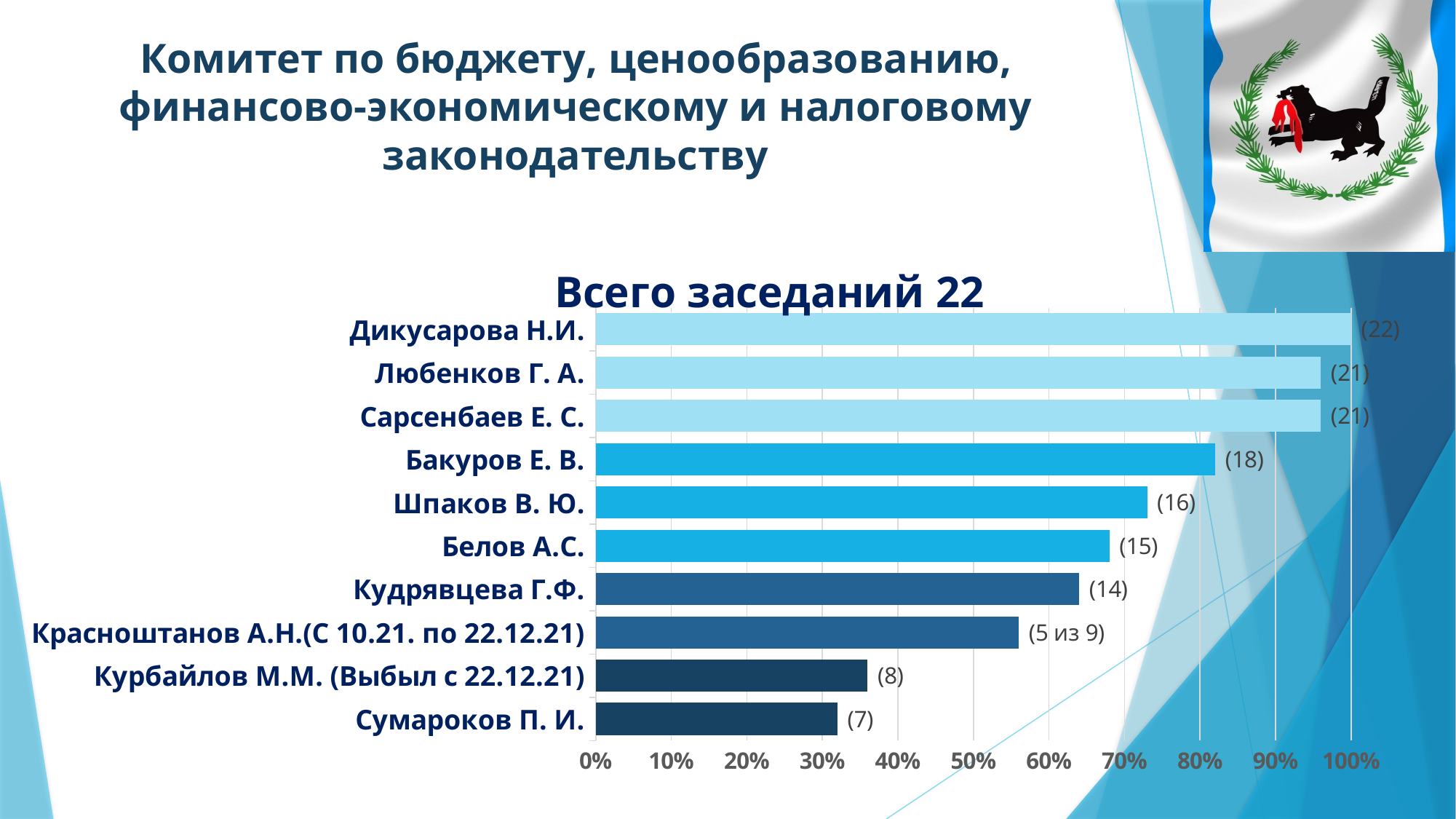
What is the data label shown for Бакуров Е. В.? (18) Which is larger, the value for Белов А.С. or the value for Кудрявцева Г.Ф.? Белов А.С. What is the title of the chart? Всего заседаний 22 How many categories (deputies) are shown in the chart? 10 What is the data label shown for Дикусарова Н.И.? (22) Which deputy has the lowest value in the chart? Сумароков П. И. Which deputy has the highest value in the chart? Дикусарова Н.И. What is the data label shown for Сумароков П. И.? (7) Is the value for Курбайлов М.М. greater or less than 40%? less Is the value for Шпаков В. Ю. greater or less than 70%? greater What kind of chart is shown on the slide? bar chart What is the data label shown for Красноштанов А.Н.? (5 из 9)